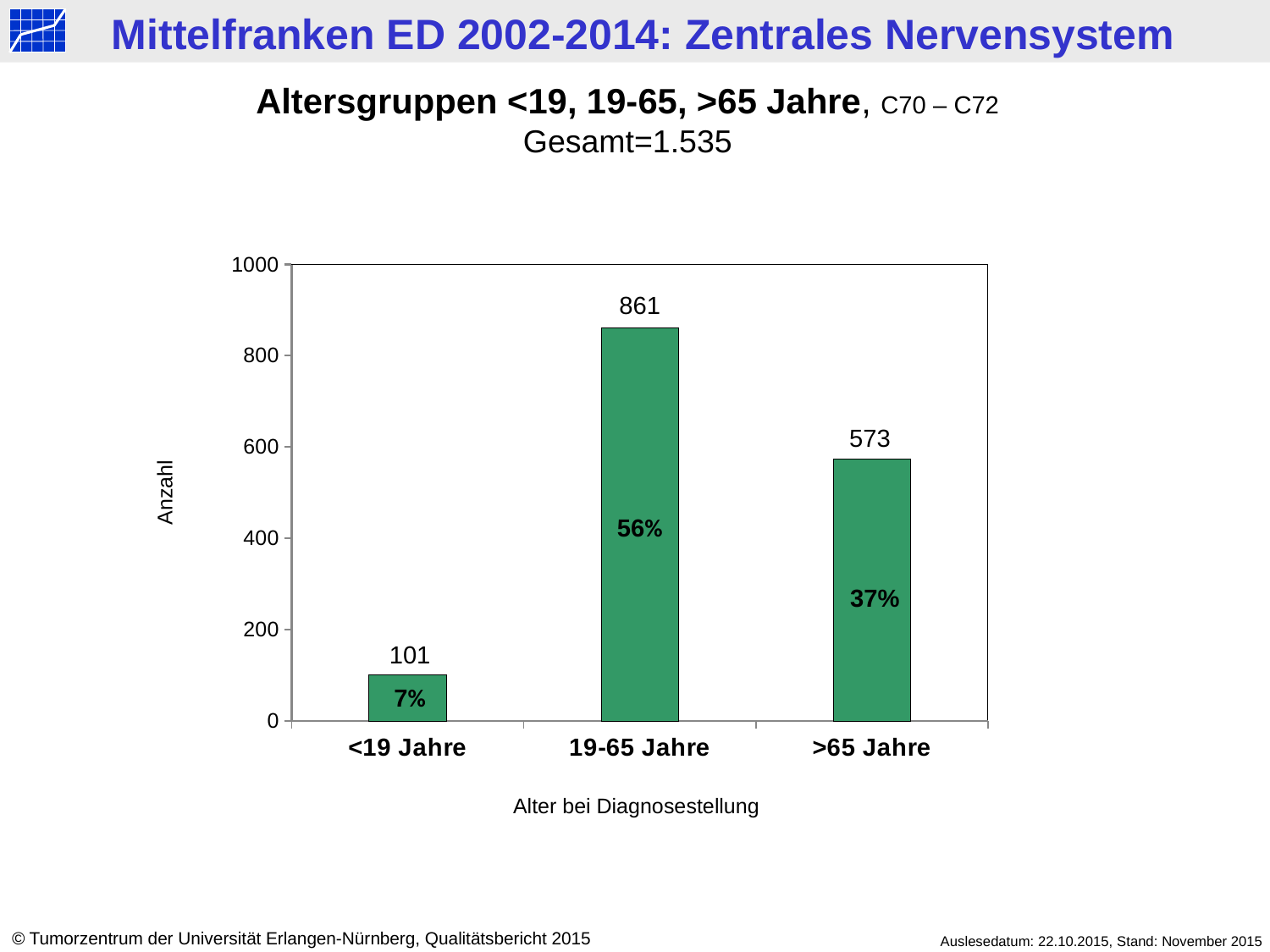
What is the label of the x axis? Alter bei Diagnosestellung What is the value (Anzahl) for the >65 Jahre age group? 573 Which is larger, the value for >65 Jahre or the value for <19 Jahre? >65 Jahre What percentage share is shown on the bar for the >65 Jahre age group? 37% What is the value (Anzahl) for the 19-65 Jahre age group? 861 How many age groups are shown on the x axis? 3 What is the difference between the values for 19-65 Jahre and >65 Jahre? 288 What is the value (Anzahl) for the <19 Jahre age group? 101 Which age group has the lowest number of cases? <19 Jahre What kind of chart is shown on the slide? bar chart Is the value for >65 Jahre greater or less than 600? less Which age group has the highest number of cases? 19-65 Jahre